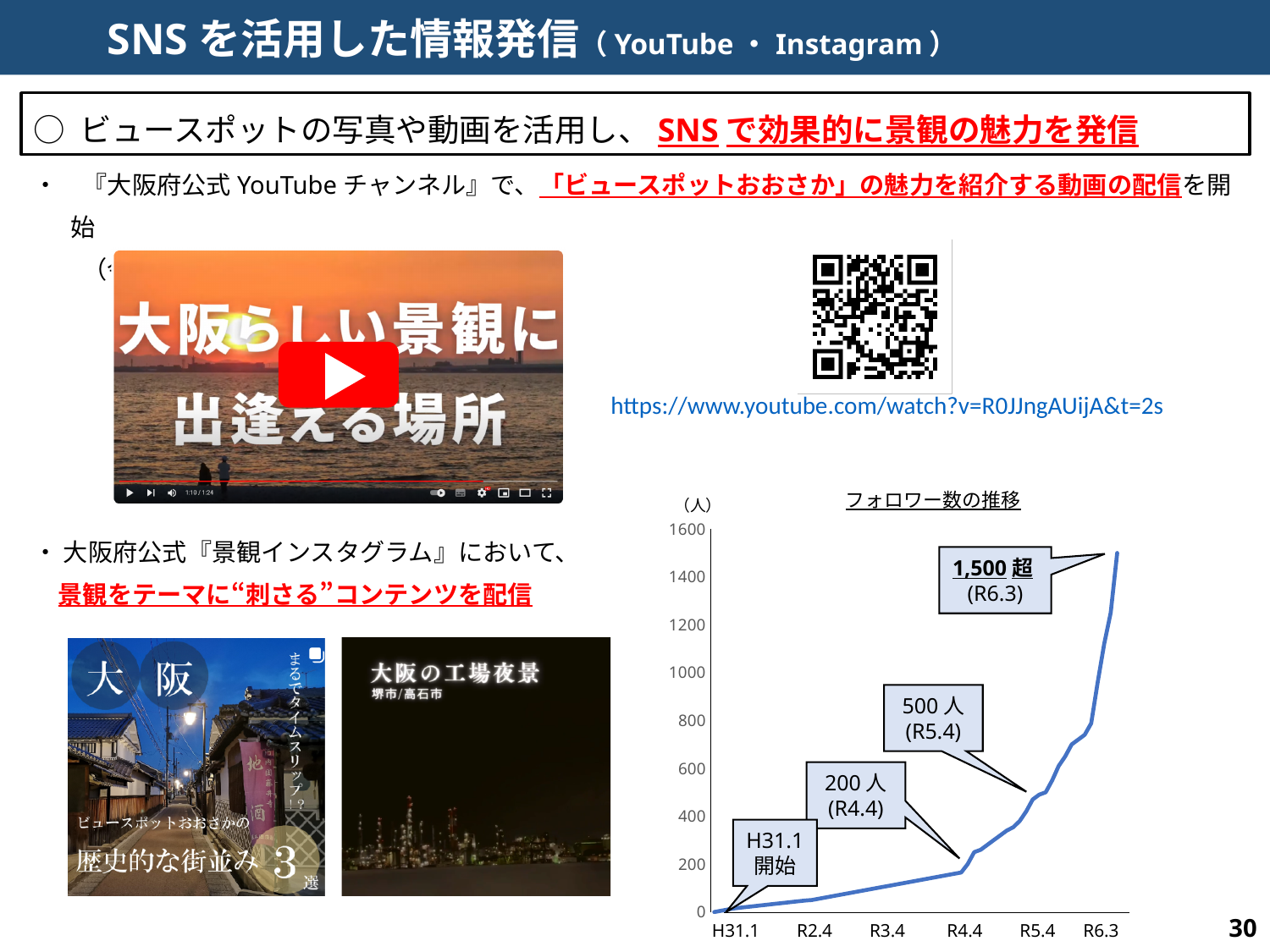
What is the title of the chart on the slide? フォロワー数の推移 At which x-axis point is the follower count lowest? H31.1 Does the follower count rise or fall from H31.1 to R6.3? rise Is the follower count at R3.4 greater or less than 200? less By how much did the follower count increase between R4.4 and R5.4? 300人 What does the label at R6.3 on the chart say the follower count is? 1,500超 What kind of chart is the フォロワー数の推移 chart? line chart According to the chart's data label, what was the follower count at R4.4? 200人 Is the follower count at R6.3 greater or less than 1400? greater According to the chart's data label, what was the follower count at R5.4? 500人 At which x-axis point is the follower count highest? R6.3 Which is larger, the follower count at R4.4 or at R5.4? R5.4